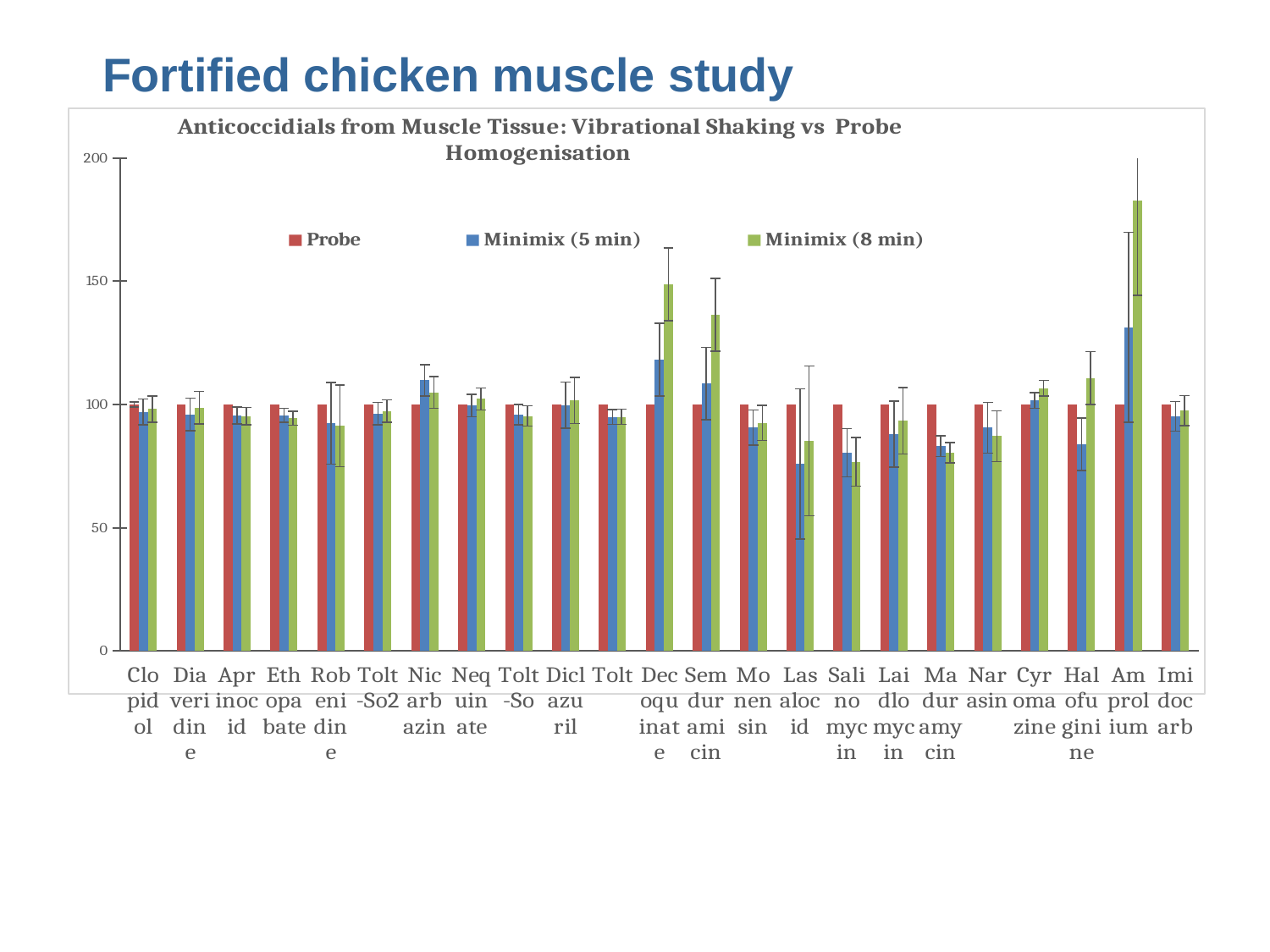
Is the Minimix (8 min) value for Decoquinate greater or less than 100? greater For Decoquinate, which is larger: the Minimix (5 min) value or the Minimix (8 min) value? Minimix (8 min) What is the Probe value for Clopidol? 100 Which colour represents the Minimix (8 min) series? green Which category has the highest Minimix (8 min) value? Amprolium How many series does the legend list? 3 Is the Minimix (8 min) value for Amprolium greater or less than 150? greater Is the Minimix (5 min) value for Lasalocid greater or less than 100? less Which category has the highest Minimix (5 min) value? Amprolium How many anticoccidial categories are plotted along the x axis? 23 What is the title of the chart? Anticoccidials from Muscle Tissue: Vibrational Shaking vs Probe Homogenisation What kind of chart is shown on the slide? bar chart